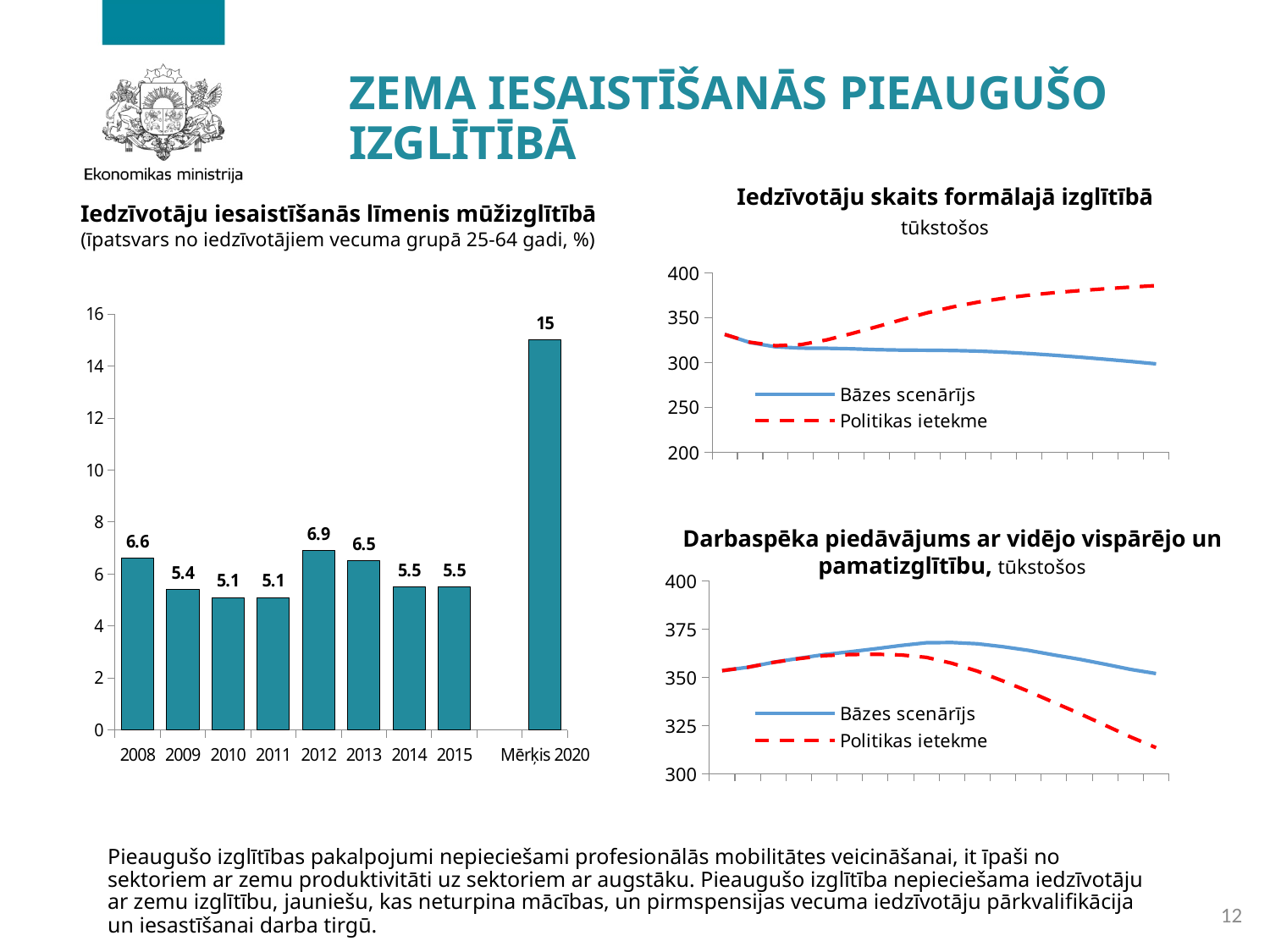
What kind of chart is 'Iedzīvotāju iesaistīšanās līmenis mūžizglītībā'? bar chart In the chart 'Iedzīvotāju iesaistīšanās līmenis mūžizglītībā', what is the difference between the value for 2008 and the value for 2009? 1.2 In the chart 'Iedzīvotāju iesaistīšanās līmenis mūžizglītībā', what is the value for 2012? 6.9 In the chart 'Darbaspēka piedāvājums ar vidējo vispārējo un pamatizglītību', does the 'Politikas ietekme' series rise or fall toward the right end of the x axis? fall What kind of chart is 'Iedzīvotāju skaits formālajā izglītībā'? line chart In the chart 'Iedzīvotāju iesaistīšanās līmenis mūžizglītībā', which is larger, the value for 2013 or the value for 2014? 2013 In the chart 'Iedzīvotāju iesaistīšanās līmenis mūžizglītībā', what is the value for Mērķis 2020? 15 How many bars are shown in the chart 'Iedzīvotāju iesaistīšanās līmenis mūžizglītībā'? 9 How many series does the legend list in the chart 'Iedzīvotāju skaits formālajā izglītībā'? 2 In the chart 'Iedzīvotāju iesaistīšanās līmenis mūžizglītībā', which year between 2008 and 2015 has the highest value? 2012 In the chart 'Iedzīvotāju skaits formālajā izglītībā', is the final value of the 'Politikas ietekme' series greater or less than 350? greater In the chart 'Darbaspēka piedāvājums ar vidējo vispārējo un pamatizglītību', is the final value of the 'Politikas ietekme' series greater or less than 325? less